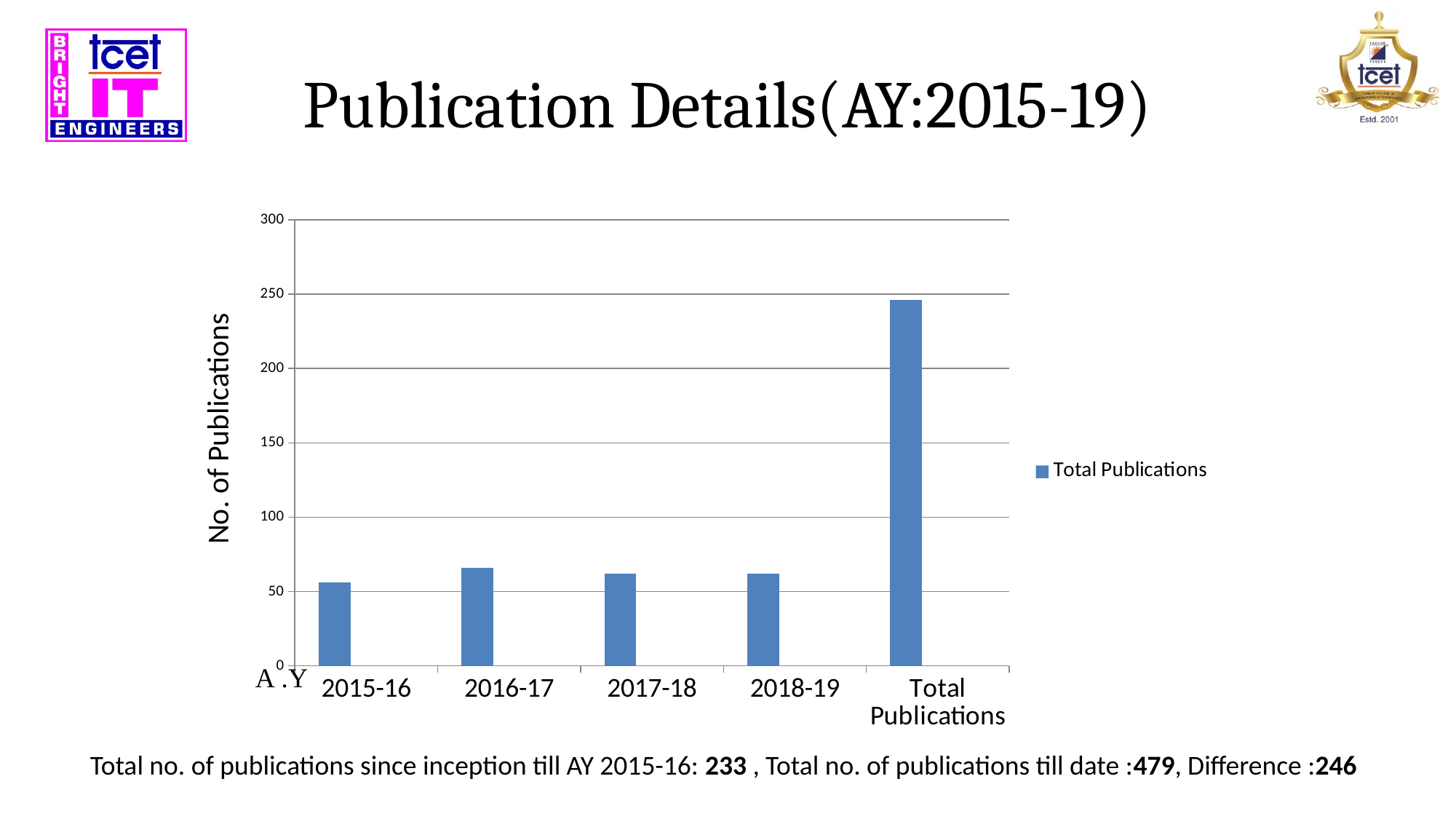
What is the title of the chart's vertical axis? No. of Publications Which academic year has the lowest bar in the chart? 2015-16 Which is larger, the value for 2015-16 or the value for 2016-17? 2016-17 How many series does the chart's legend list? 1 What is the name of the series shown in the chart's legend? Total Publications Is the value for 2018-19 greater or less than 50? greater How many categories are shown on the x axis of the chart? 5 Is the value for 2015-16 greater or less than 50? greater Which category has the highest bar in the chart? Total Publications Is the value for 2016-17 greater or less than 100? less What kind of chart is shown on the slide? bar chart